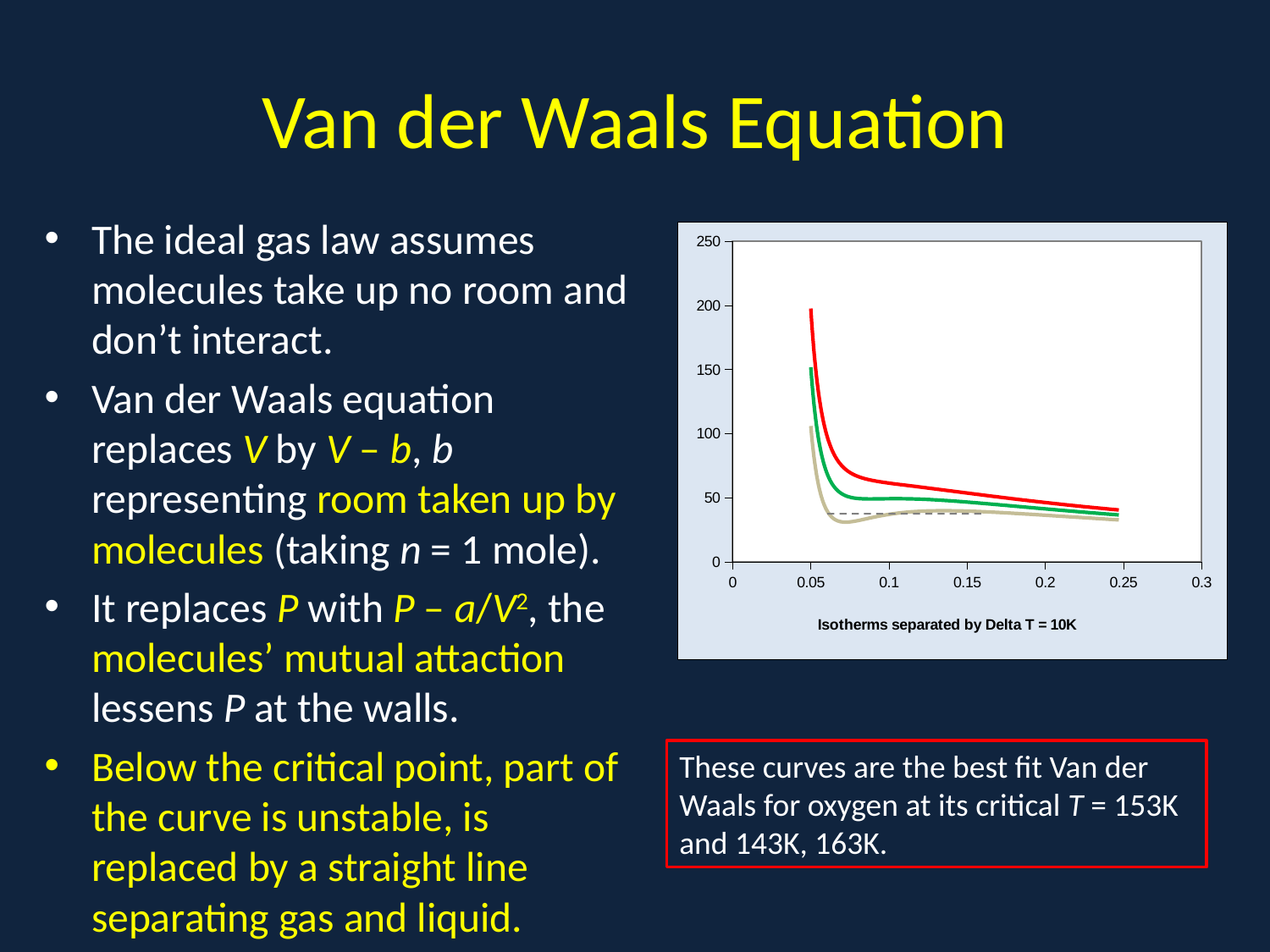
Which coloured curve lies highest on the chart? red What is the highest value labelled on the y-axis? 250 How many solid coloured curves are plotted on the chart? 3 Which coloured curve lies lowest on the chart? tan What is the title printed below the chart? Isotherms separated by Delta T = 10K Which curve is higher at x = 0.15, the red curve or the green curve? red Is the starting value of the tan curve near x = 0.05 greater or less than 150? less Do the curves rise or fall as the x-axis value increases? fall What kind of chart is shown on the slide? line chart Is the value of the red curve at x = 0.2 greater or less than 100? less Is the starting value of the red curve near x = 0.05 greater or less than 150? greater